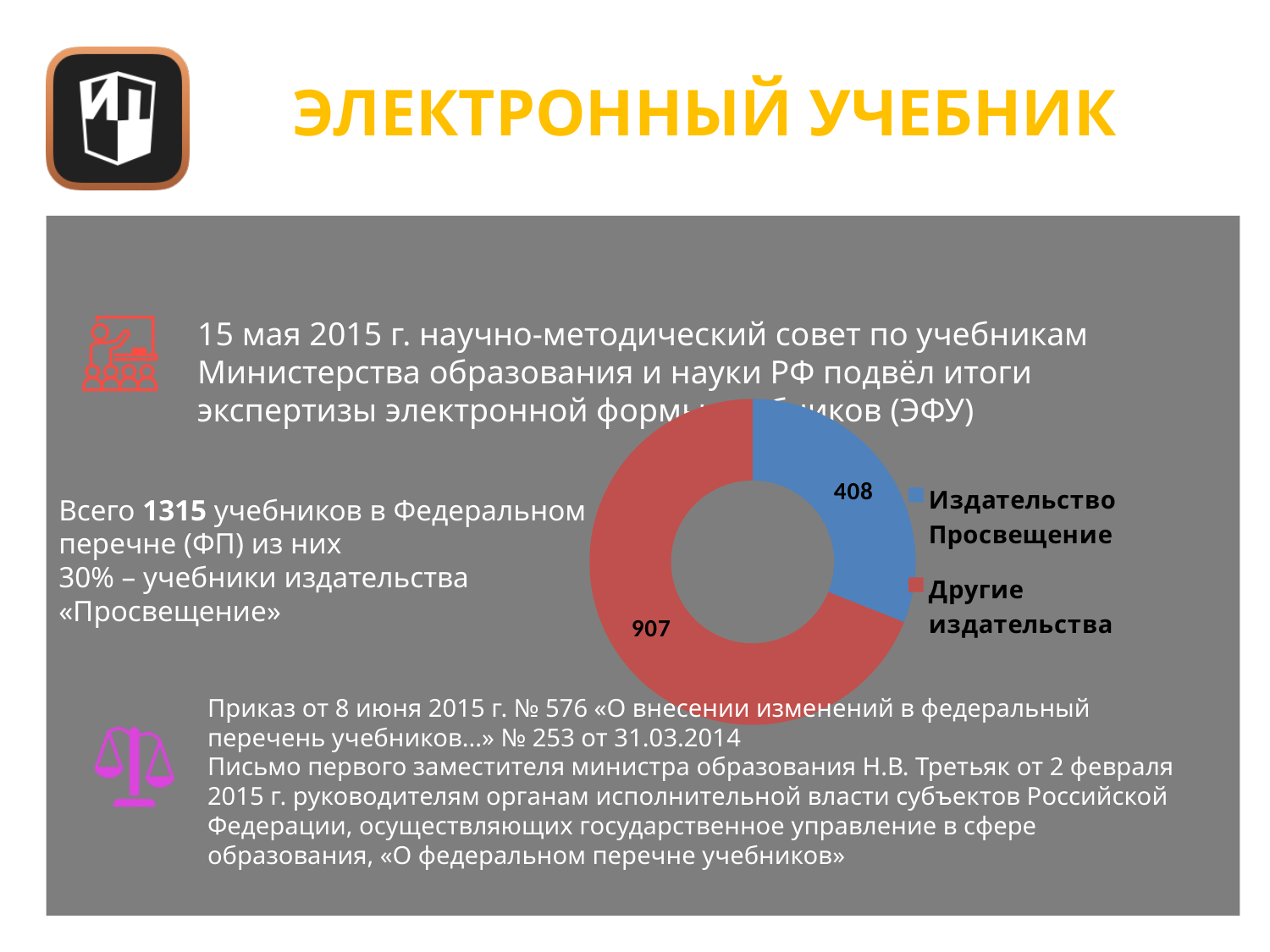
What is the difference between the values for Другие издательства and Издательство Просвещение? 499 What kind of chart is shown on the slide? doughnut chart What value is shown for Другие издательства in the chart? 907 What colour is the slice for Другие издательства? red What colour is the slice for Издательство Просвещение? blue Which is larger: the value for Издательство Просвещение or the value for Другие издательства? Другие издательства What value is shown for Издательство Просвещение in the chart? 408 What is the total of the two values shown in the chart? 1315 Which category has the smallest value in the chart? Издательство Просвещение How many categories does the chart show? 2 Which category has the largest value in the chart? Другие издательства